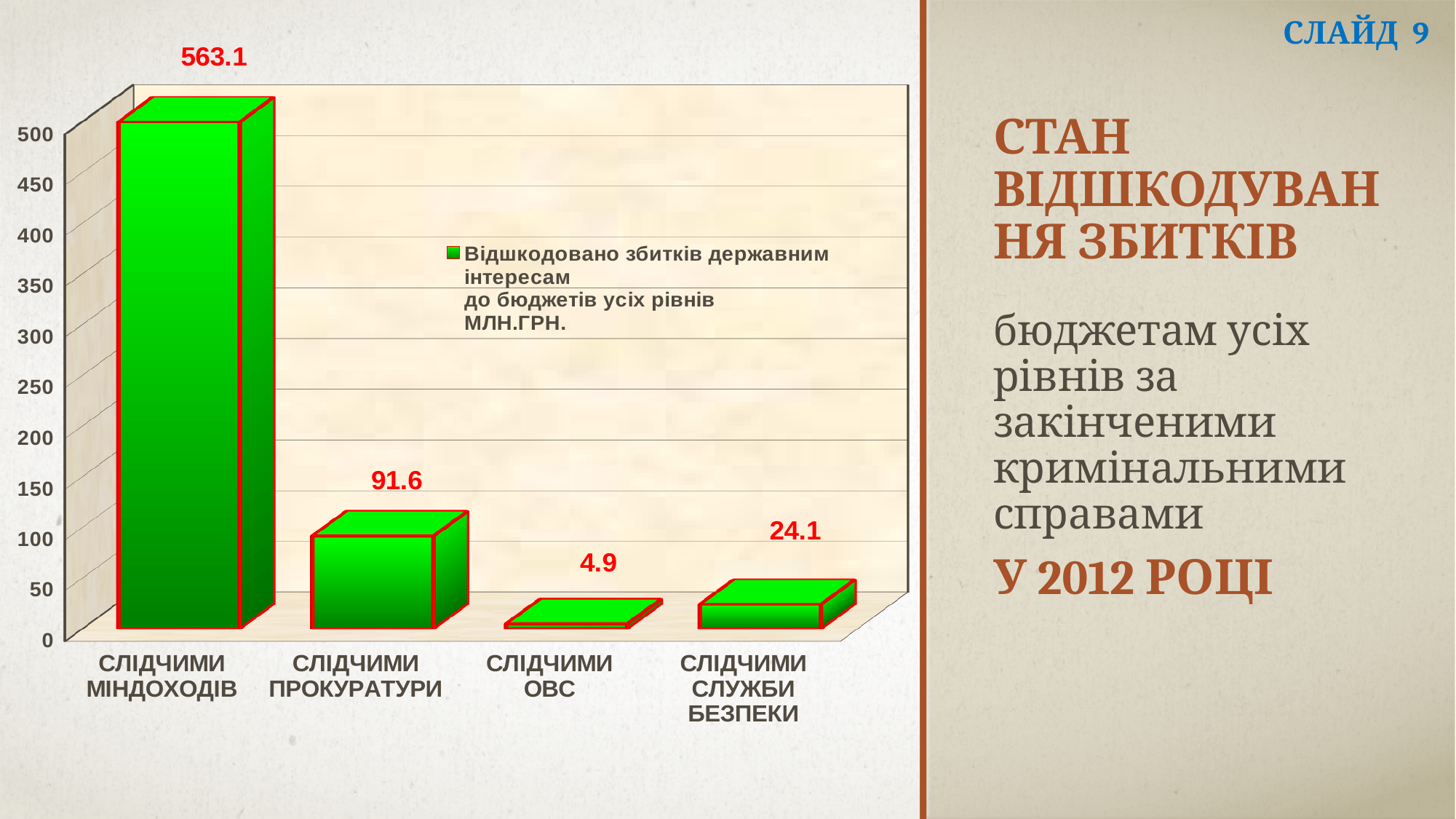
What value is shown for СЛІДЧИМИ МІНДОХОДІВ? 563.1 What value is shown for СЛІДЧИМИ СЛУЖБИ БЕЗПЕКИ? 24.1 How many series does the chart legend list? 1 What value is shown for СЛІДЧИМИ ПРОКУРАТУРИ? 91.6 What value is shown for СЛІДЧИМИ ОВС? 4.9 Which category has the lowest value? СЛІДЧИМИ ОВС Which category has the highest value? СЛІДЧИМИ МІНДОХОДІВ Which is larger, the value for СЛІДЧИМИ ПРОКУРАТУРИ or the value for СЛІДЧИМИ СЛУЖБИ БЕЗПЕКИ? СЛІДЧИМИ ПРОКУРАТУРИ What is the difference between the values for СЛІДЧИМИ МІНДОХОДІВ and СЛІДЧИМИ ПРОКУРАТУРИ? 471.5 What kind of chart is shown on the slide? Bar chart What is the difference between the values for СЛІДЧИМИ СЛУЖБИ БЕЗПЕКИ and СЛІДЧИМИ ОВС? 19.2 How many categories are shown on the x axis of the chart? 4